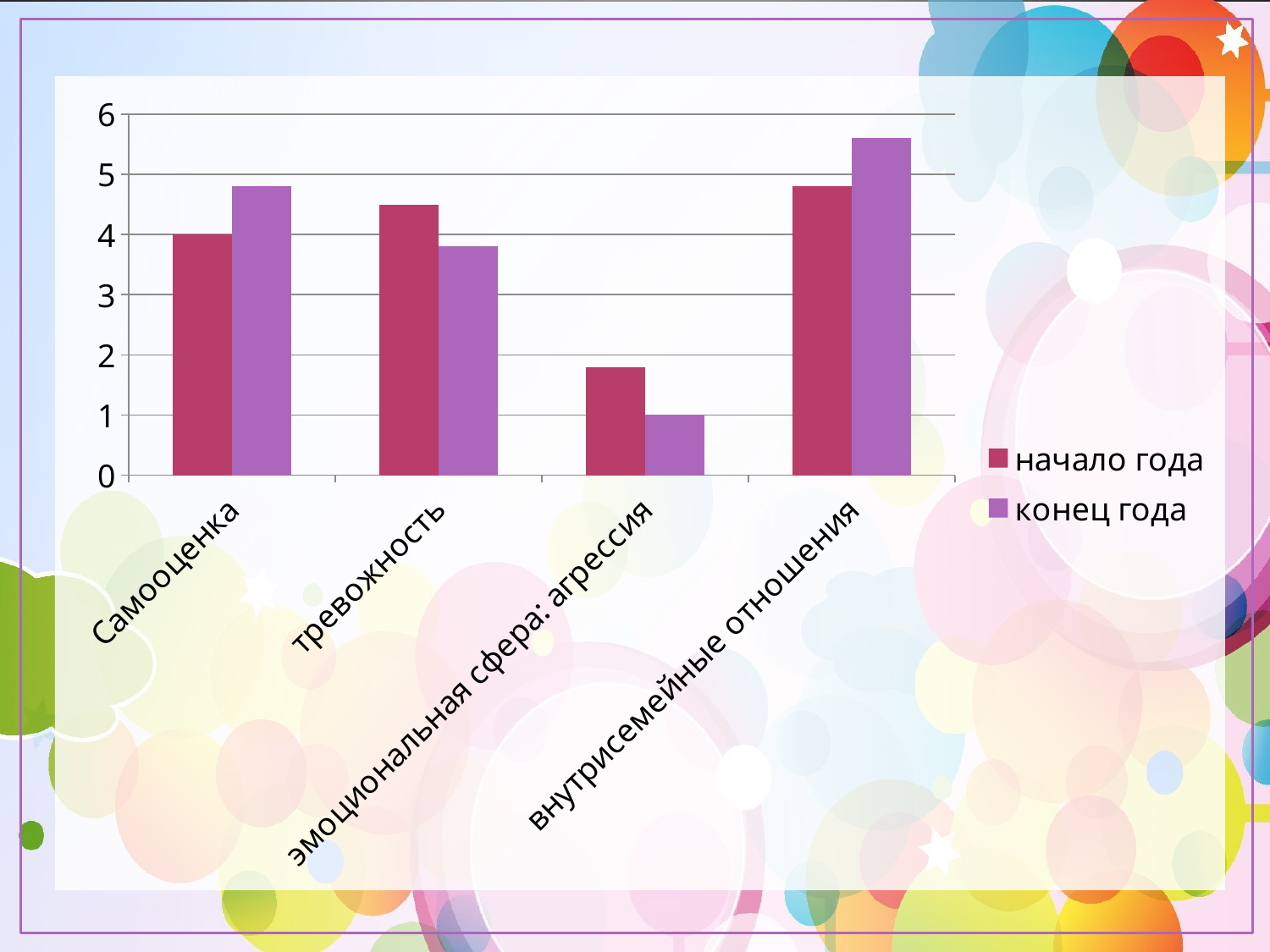
Which category has the lowest начало года value? эмоциональная сфера: агрессия How many series does the legend list? 2 What are the two legend entries of the chart? начало года, конец года What is the value for Самооценка in the начало года series? 4 What is the value for эмоциональная сфера: агрессия in the конец года series? 1 What kind of chart is shown on the slide? bar chart How many categories are shown on the x axis? 4 For Самооценка, which is larger: the начало года value or the конец года value? конец года For тревожность, which is larger: the начало года value or the конец года value? начало года Is the начало года value for эмоциональная сфера: агрессия greater or less than 2? less Is the конец года value for внутрисемейные отношения greater or less than 5? greater Which category has the highest конец года value? внутрисемейные отношения